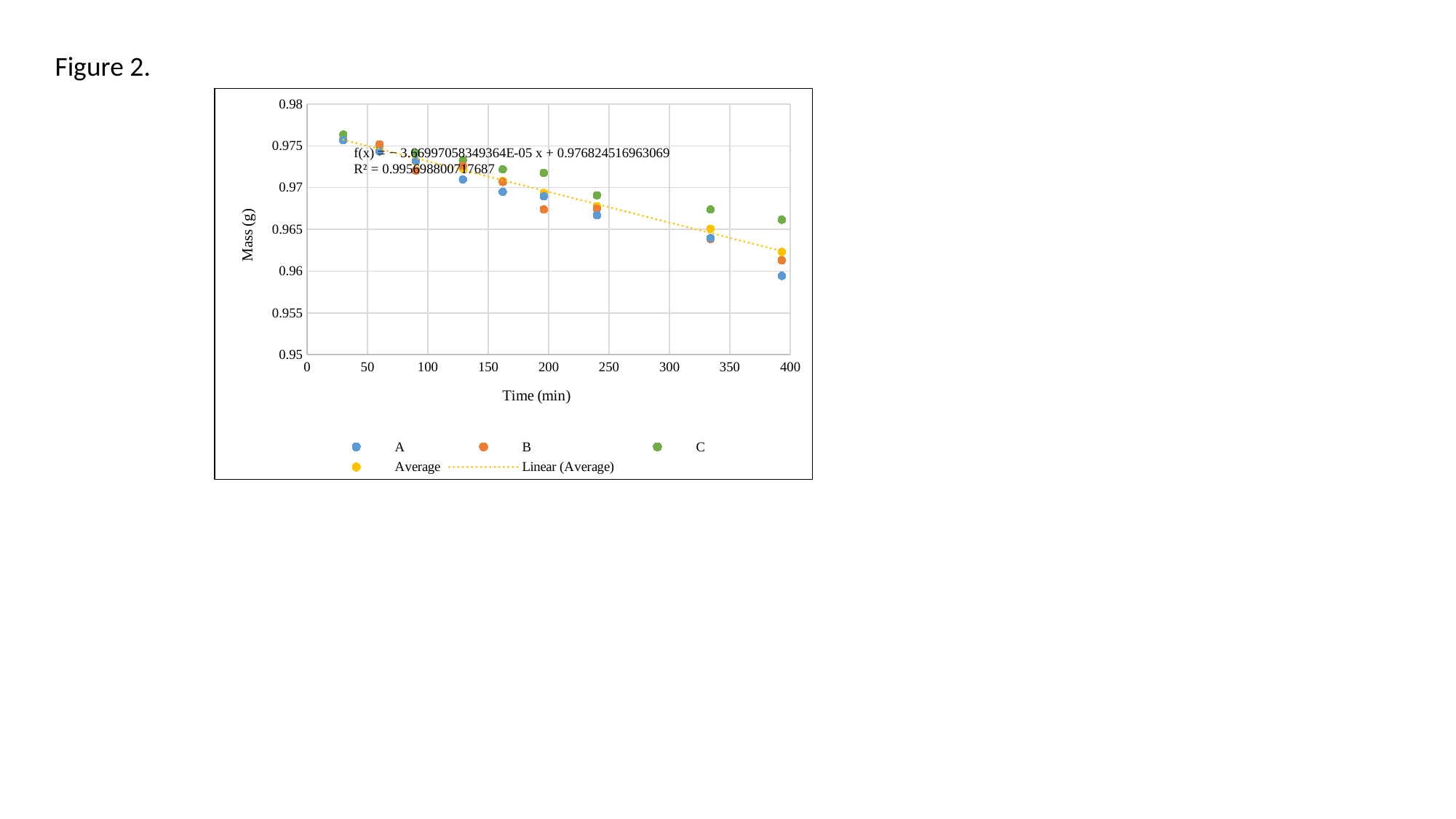
Do the mass values rise or fall as time increases along the x axis? Fall How many time points are plotted for series A? 9 Is the value for series C at around 30 min greater or less than 0.975? greater What is the title of the y axis? Mass (g) Is the value for series A at around 240 min greater or less than 0.97? less At the last time point (around 395 min), which series has the lowest mass? A What kind of chart is shown on the slide? Scatter chart At the last time point (around 395 min), which series has the highest mass? C How many entries does the chart legend list? 5 At around 335 min, is the value for series A or series C larger? C What is the R² value printed on the chart? 0.995698800717687 At around 195 min, is the value for series B or series C larger? C